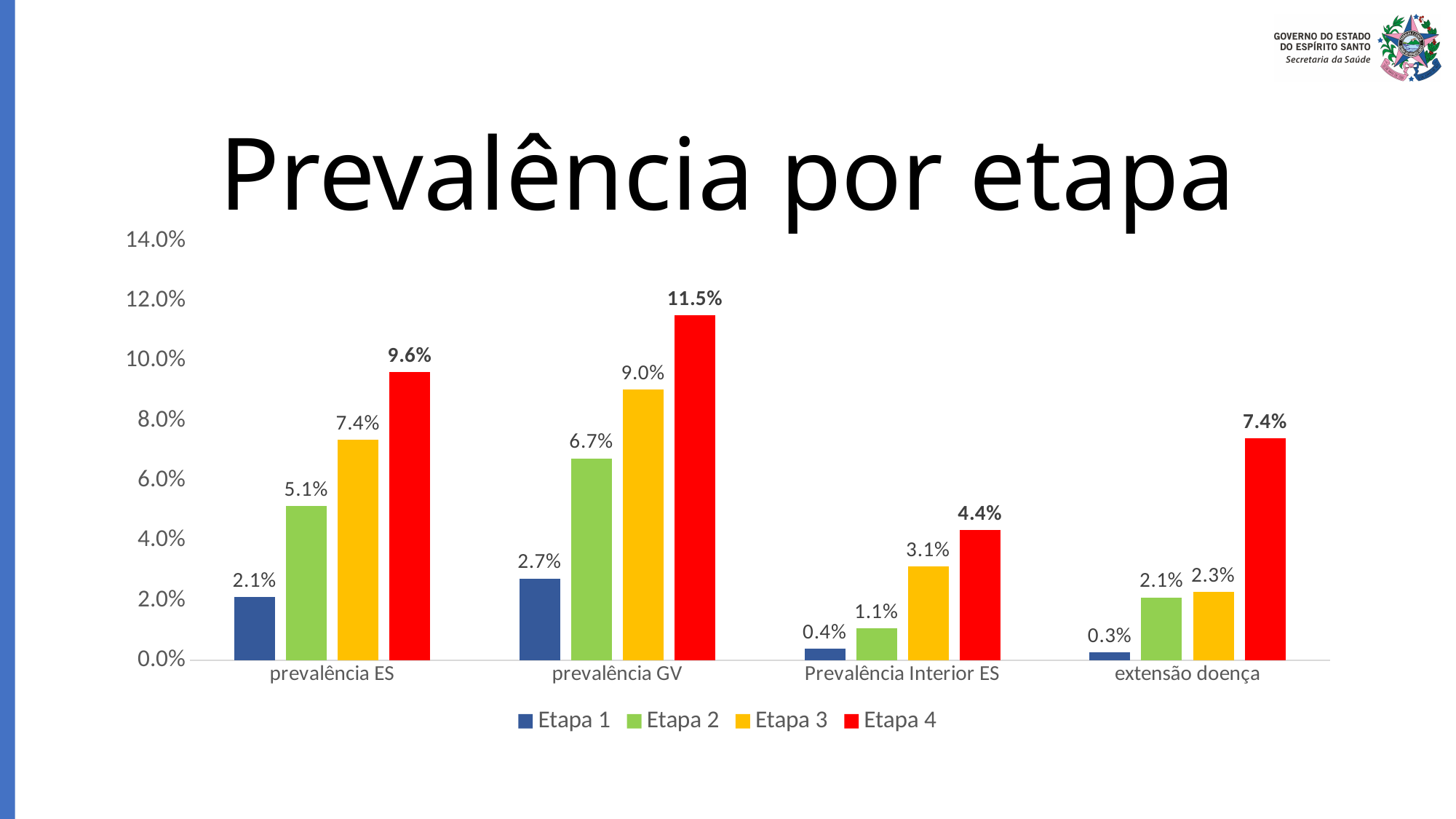
How many series does the legend list? 4 What is the value for Etapa 1 in the extensão doença category? 0.3% Which category has the lowest Etapa 1 value? extensão doença How many categories are shown on the x axis? 4 What is the title of the slide? Prevalência por etapa Is the Etapa 4 value for prevalência GV greater or less than 10.0%? greater Which category has the highest Etapa 4 value? prevalência GV What is the value for Etapa 3 in the Prevalência Interior ES category? 3.1% Which is larger: the Etapa 2 value for prevalência GV or the Etapa 2 value for prevalência ES? prevalência GV What kind of chart is shown on the slide? bar chart What is the difference between the Etapa 4 and Etapa 3 values in the prevalência ES category? 2.2% What is the value for Etapa 4 in the prevalência GV category? 11.5%